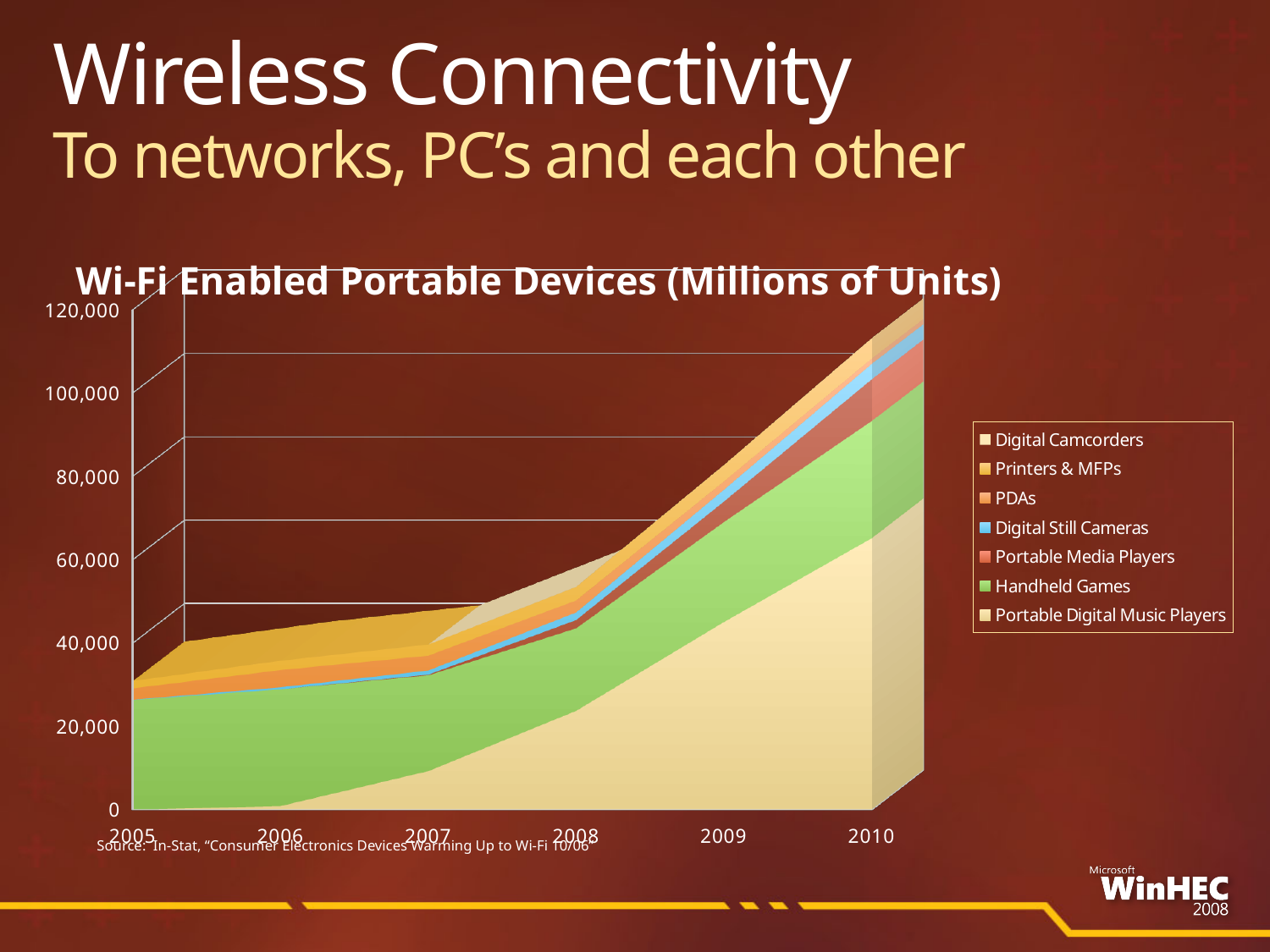
Which series is listed last in the chart's legend? Portable Digital Music Players In which year is the total of all series lowest? 2005 Is the total value for 2005 greater or less than 60,000? less What is the title of the chart? Wi-Fi Enabled Portable Devices (Millions of Units) How many years are shown along the x axis of the chart? 6 Is the value for Portable Digital Music Players in 2010 greater or less than 60,000? greater Do the total values in the chart rise or fall from 2005 to 2010? Rise Is the total value for 2010 greater or less than 100,000? greater In which year is the total of all series highest? 2010 Which year has the larger total value, 2005 or 2010? 2010 What kind of chart is shown on the slide? Area chart How many series does the chart's legend list? 7